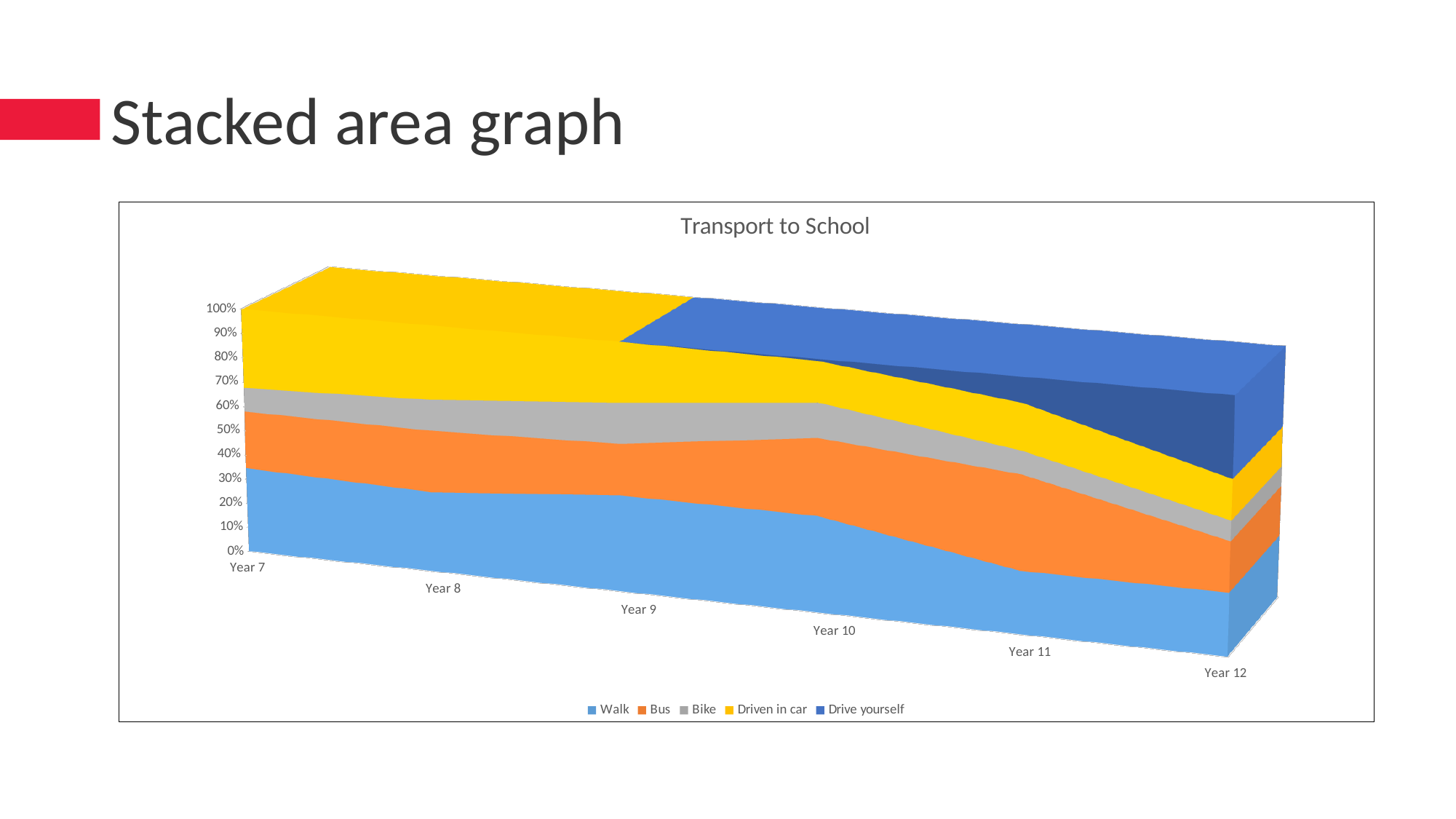
Is the share for Walk at Year 7 greater or less than 20%? greater Which series is shown in yellow in the legend? Driven in car Which series has the largest share at Year 12? Drive yourself What is the title of the chart? Transport to School Does the share for Drive yourself rise or fall from Year 7 to Year 12? Rise Which series has the smallest share at Year 12? Bike What is the first category on the x axis? Year 7 How many year groups are shown along the x axis? 6 Does the share for Walk rise or fall from Year 7 to Year 12? Fall Which series has no share at Year 7? Drive yourself What kind of chart is shown on the slide? Stacked area chart How many series does the legend list? 5